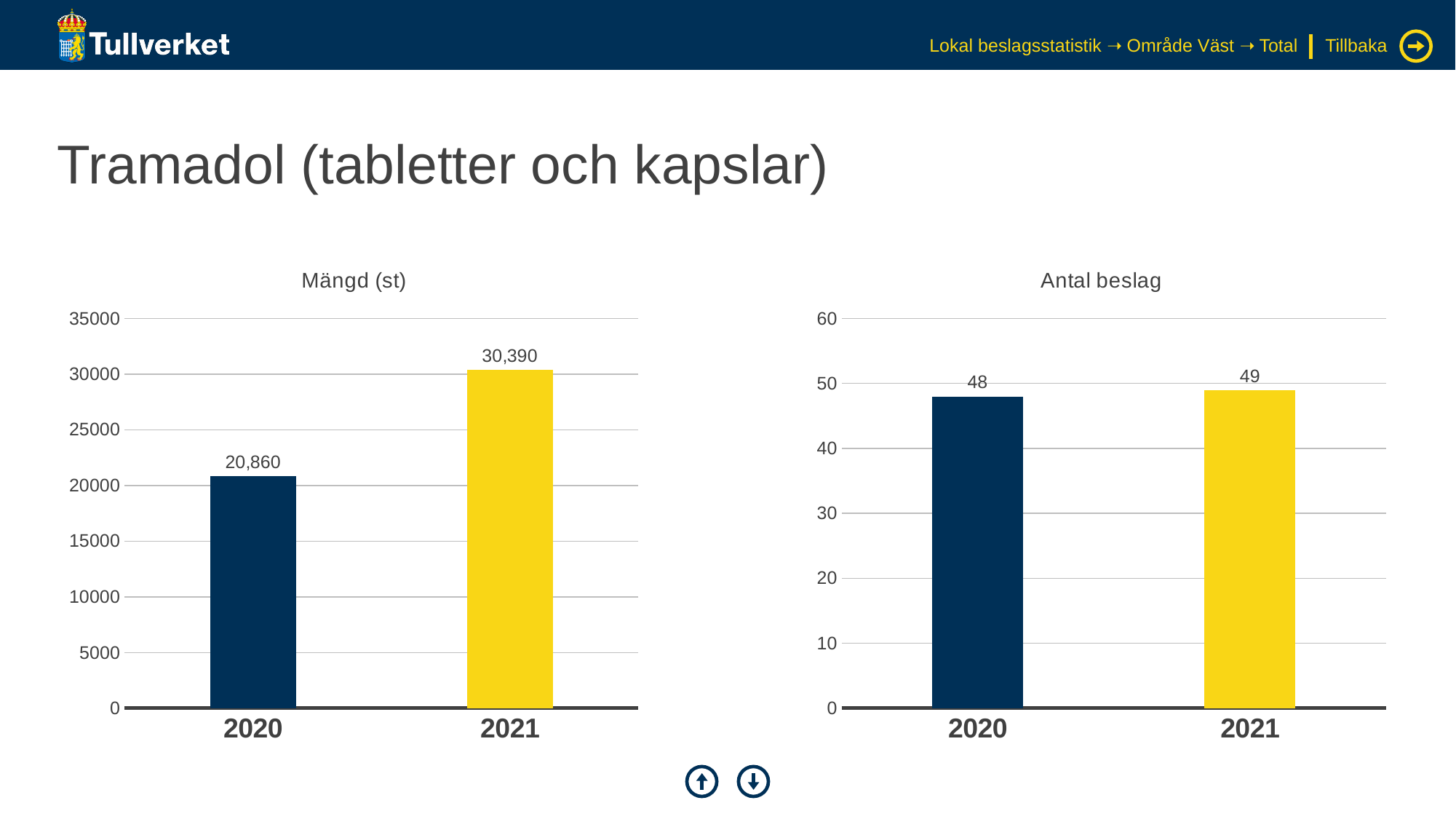
In the 'Antal beslag' chart, what is the value for 2021? 49 In the 'Mängd (st)' chart, is the value for 2021 greater or less than 25000? greater In the 'Mängd (st)' chart, what is the value for 2020? 20,860 In the 'Antal beslag' chart, what is the value for 2020? 48 In the 'Mängd (st)' chart, what is the difference between the 2021 and 2020 values? 9,530 How many years are shown in the 'Antal beslag' chart? 2 In the 'Antal beslag' chart, what is the difference between the 2021 and 2020 values? 1 In the 'Mängd (st)' chart, do the values rise or fall from 2020 to 2021? rise In the 'Mängd (st)' chart, what is the value for 2021? 30,390 In the 'Mängd (st)' chart, which year has the lowest value? 2020 What kind of chart is the 'Mängd (st)' chart? bar chart In the 'Mängd (st)' chart, which year has the highest value? 2021